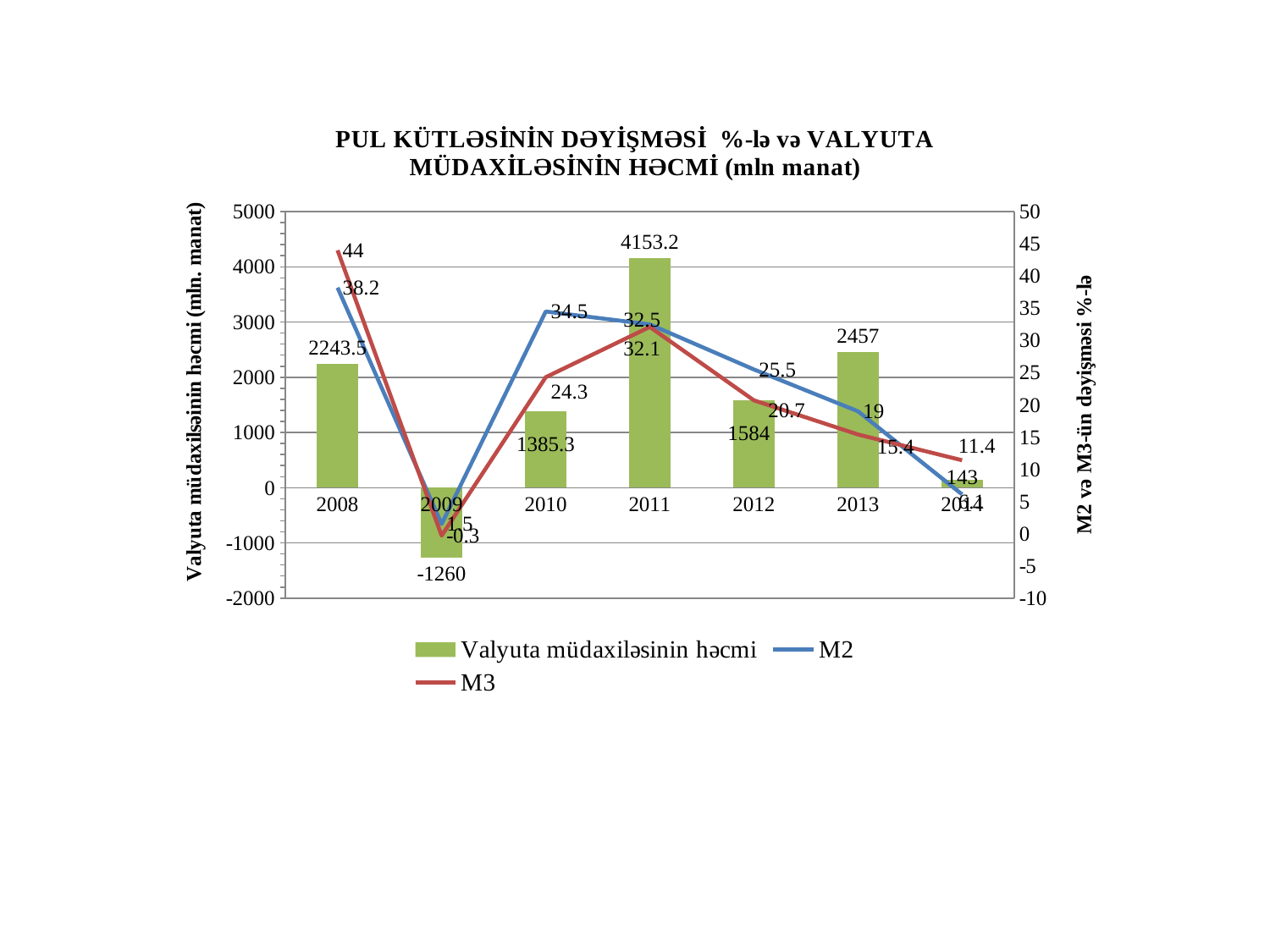
How many years are shown on the x axis? 7 What is the M3 value for 2014? 11.4 What kind of chart is this? Combination bar and line chart What is the value of Valyuta müdaxiləsinin həcmi for 2011? 4153.2 What is the M3 value for 2008? 44 In which year is the Valyuta müdaxiləsinin həcmi bar the lowest? 2009 What is the difference between the Valyuta müdaxiləsinin həcmi values for 2013 and 2012? 873 In which year is the Valyuta müdaxiləsinin həcmi bar the highest? 2011 What is the M2 value for 2010? 34.5 How many series does the legend list? 3 Does the M3 line rise or fall from 2011 to 2014? Fall In 2012, which is larger, M2 or M3? M2